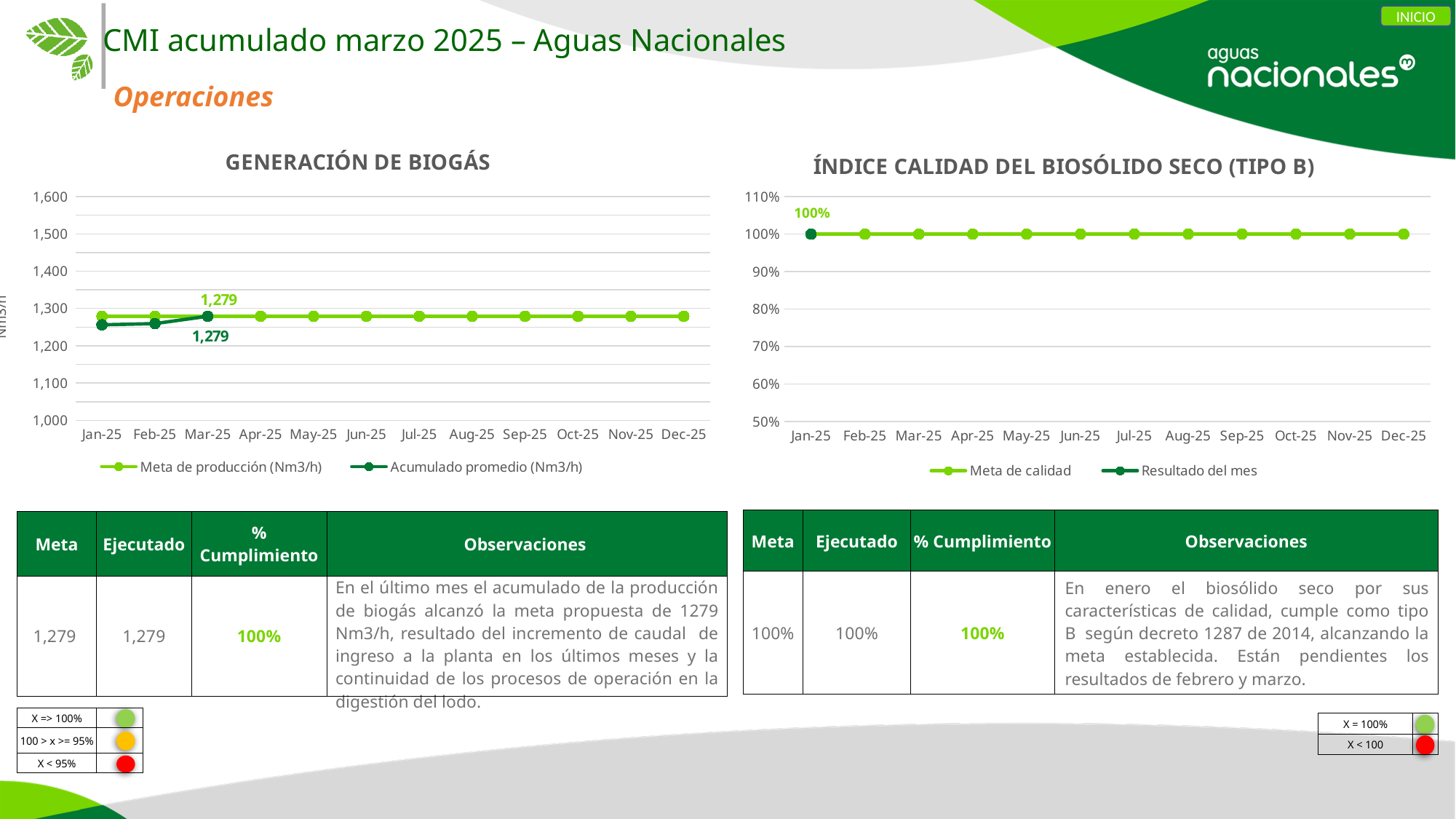
On the GENERACIÓN DE BIOGÁS chart, how many series does the legend list? 2 On the GENERACIÓN DE BIOGÁS chart, what is the value of Acumulado promedio (Nm3/h) for Mar-25? 1,279 On the ÍNDICE CALIDAD DEL BIOSÓLIDO SECO (TIPO B) chart, how many series does the legend list? 2 On the GENERACIÓN DE BIOGÁS chart, is the value of Acumulado promedio (Nm3/h) for Feb-25 greater or less than 1,200? greater On the GENERACIÓN DE BIOGÁS chart, what is the value of Meta de producción (Nm3/h) for Mar-25? 1,279 On the ÍNDICE CALIDAD DEL BIOSÓLIDO SECO (TIPO B) chart, what kind of chart is used? Line chart On the GENERACIÓN DE BIOGÁS chart, how many months are shown on the x axis? 12 On the GENERACIÓN DE BIOGÁS chart, what kind of chart is used? Line chart On the ÍNDICE CALIDAD DEL BIOSÓLIDO SECO (TIPO B) chart, what is the value of Resultado del mes for Jan-25? 100% On the GENERACIÓN DE BIOGÁS chart, is the value of Acumulado promedio (Nm3/h) for Jan-25 greater or less than 1,300? less On the ÍNDICE CALIDAD DEL BIOSÓLIDO SECO (TIPO B) chart, is the value of Meta de calidad for Dec-25 greater or less than 90%? greater On the GENERACIÓN DE BIOGÁS chart, does the Acumulado promedio (Nm3/h) series rise or fall from Jan-25 to Mar-25? Rise